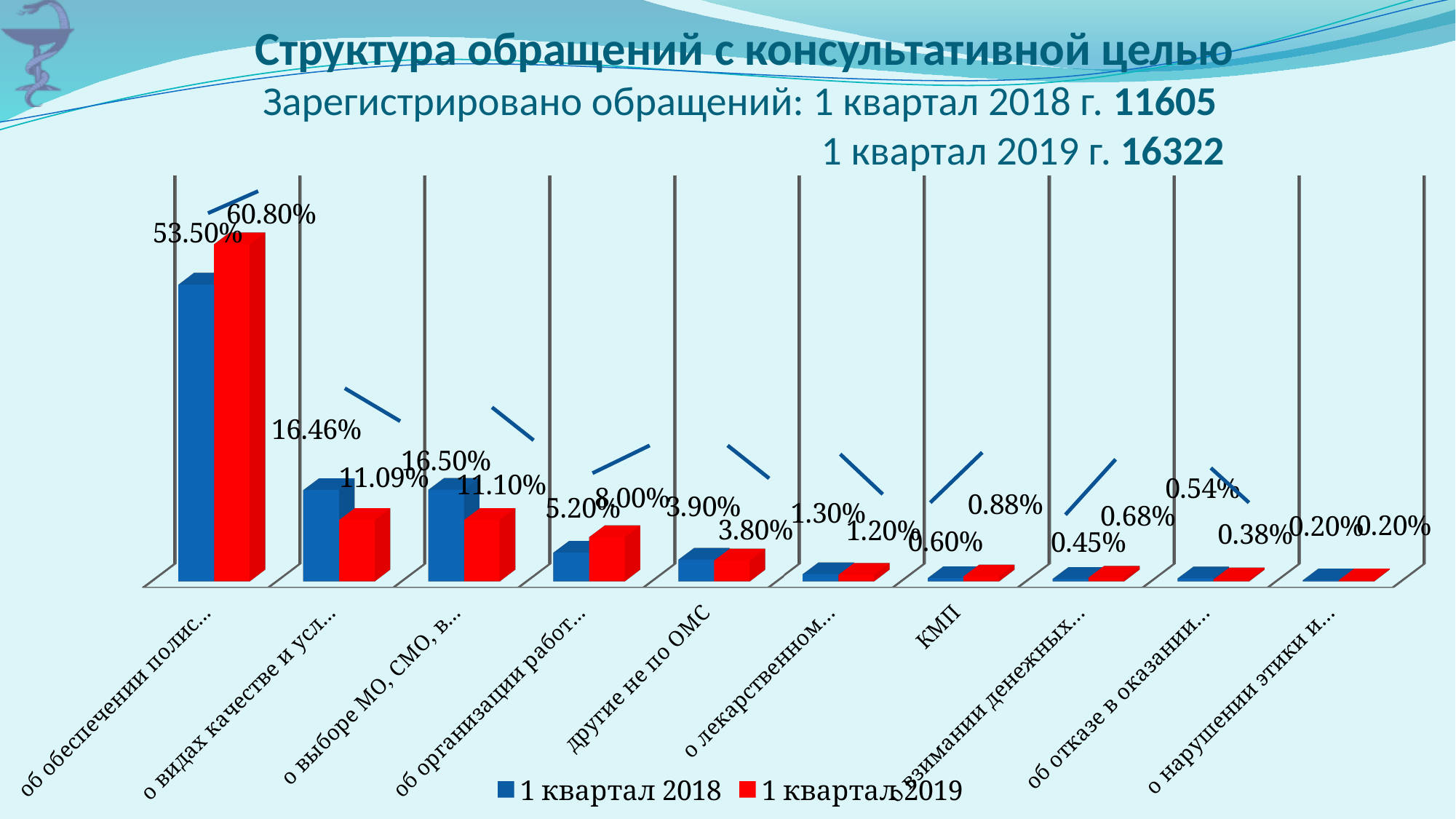
How many series does the legend list? 2 What is the value for 'другие не по ОМС' in the 1 квартал 2018 series? 3.90% What are the two entries in the chart legend? 1 квартал 2018 and 1 квартал 2019 What is the lowest value shown in the 1 квартал 2019 series? 0.20% Which category has the highest value in the 1 квартал 2019 series? об обеспечении полис... (the first category) What is the difference between the 1 квартал 2019 and 1 квартал 2018 values for the first category (об обеспечении полис...)? 7.30% What is the value of the 1 квартал 2019 bar for the first category (об обеспечении полис...)? 60.80% What is the value for КМП in the 1 квартал 2019 series? 0.88% What is the difference between the 1 квартал 2019 and 1 квартал 2018 values for КМП? 0.28% For КМП, which series has the larger value, 1 квартал 2018 or 1 квартал 2019? 1 квартал 2019 What kind of chart is shown on the slide? bar chart How many categories are shown on the x axis of the chart? 10